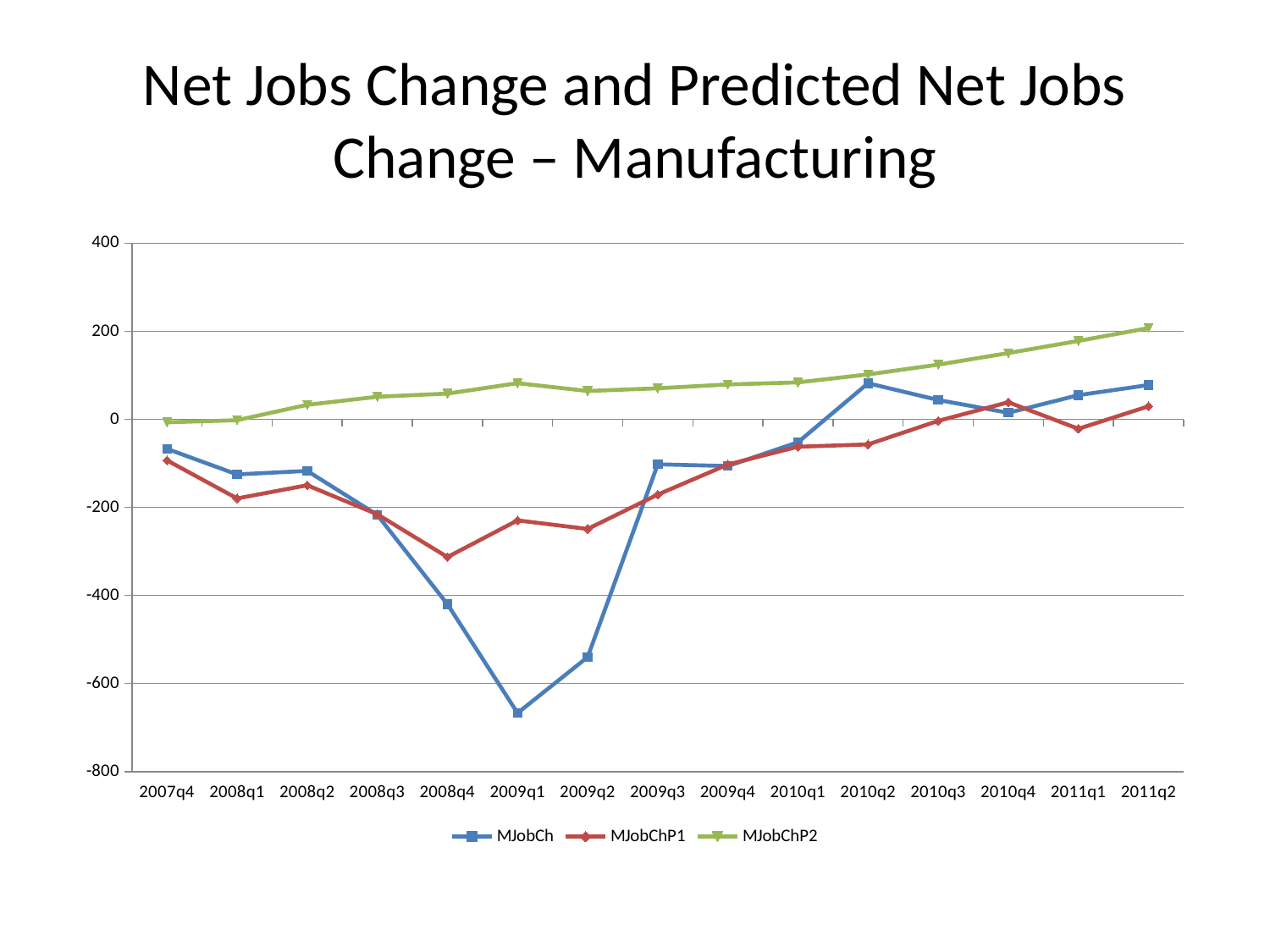
How many quarters are plotted along the x axis? 15 How many series does the legend list? 3 Is the value for MJobCh in 2008q4 greater or less than -400? less Is the value for MJobChP1 in 2008q4 greater or less than -200? less In which quarter does the MJobCh series reach its lowest value? 2009q1 In which quarter does the MJobChP2 series reach its highest value? 2011q2 Is the value for MJobCh in 2009q1 greater or less than -600? less In 2008q4, which series has the larger value, MJobCh or MJobChP1? MJobChP1 What kind of chart is shown on the slide? line chart Does the MJobChP2 series generally rise or fall from 2007q4 to 2011q2? rise What is the title of the chart on the slide? Net Jobs Change and Predicted Net Jobs Change – Manufacturing